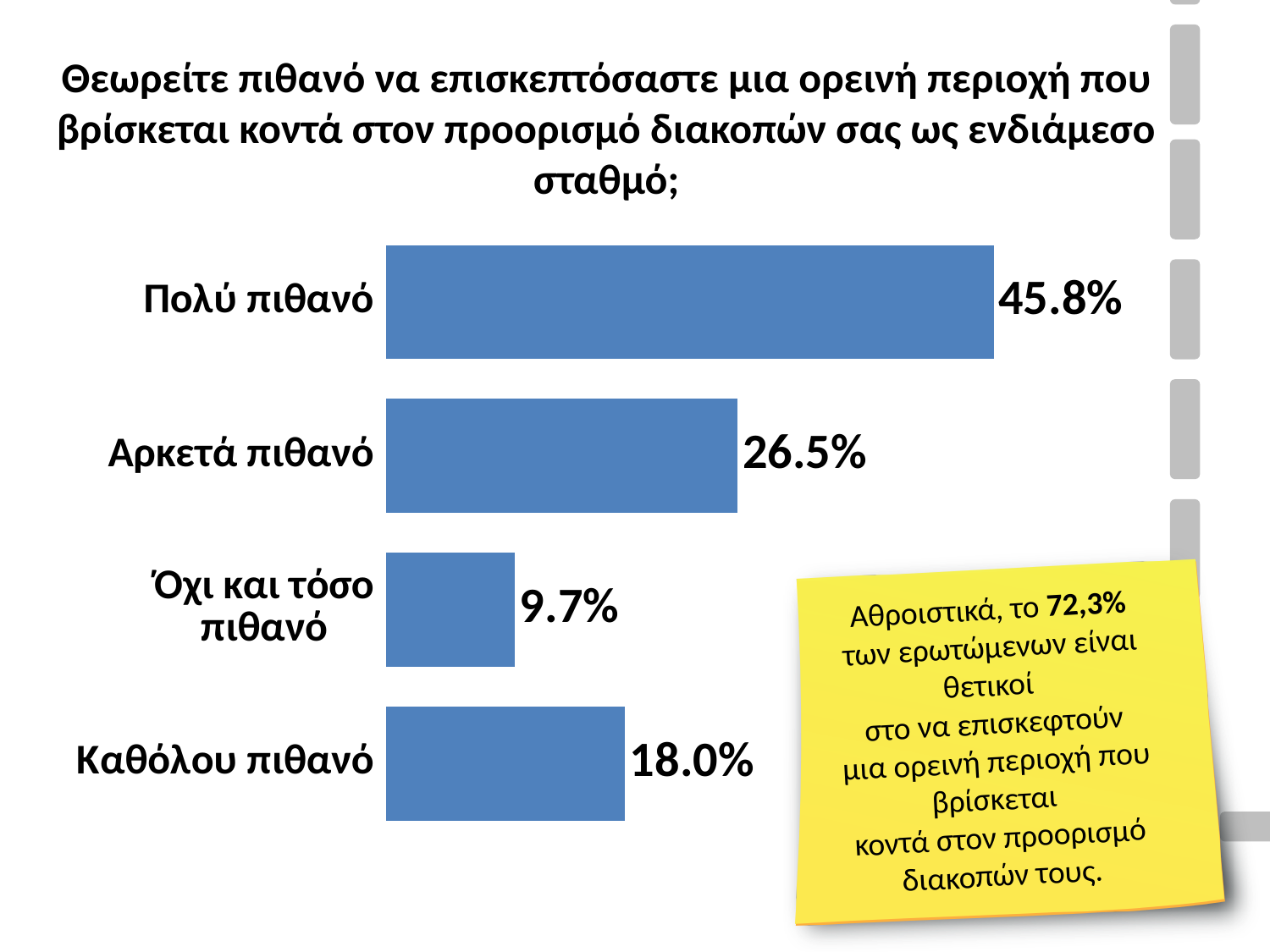
What is the value for Αρκετά πιθανό? 26.5% What is the value for Πολύ πιθανό? 45.8% What is the value for Όχι και τόσο πιθανό? 9.7% What is the value for Καθόλου πιθανό? 18.0% What is the difference between the values for Καθόλου πιθανό and Όχι και τόσο πιθανό? 8.3% Which is larger, the value for Καθόλου πιθανό or the value for Όχι και τόσο πιθανό? Καθόλου πιθανό What colour are the bars in the chart? Blue What is the difference between the values for Πολύ πιθανό and Αρκετά πιθανό? 19.3% How many categories are shown in the chart? 4 Which category has the lowest value? Όχι και τόσο πιθανό Which category has the highest value? Πολύ πιθανό What kind of chart is shown on the slide? Bar chart